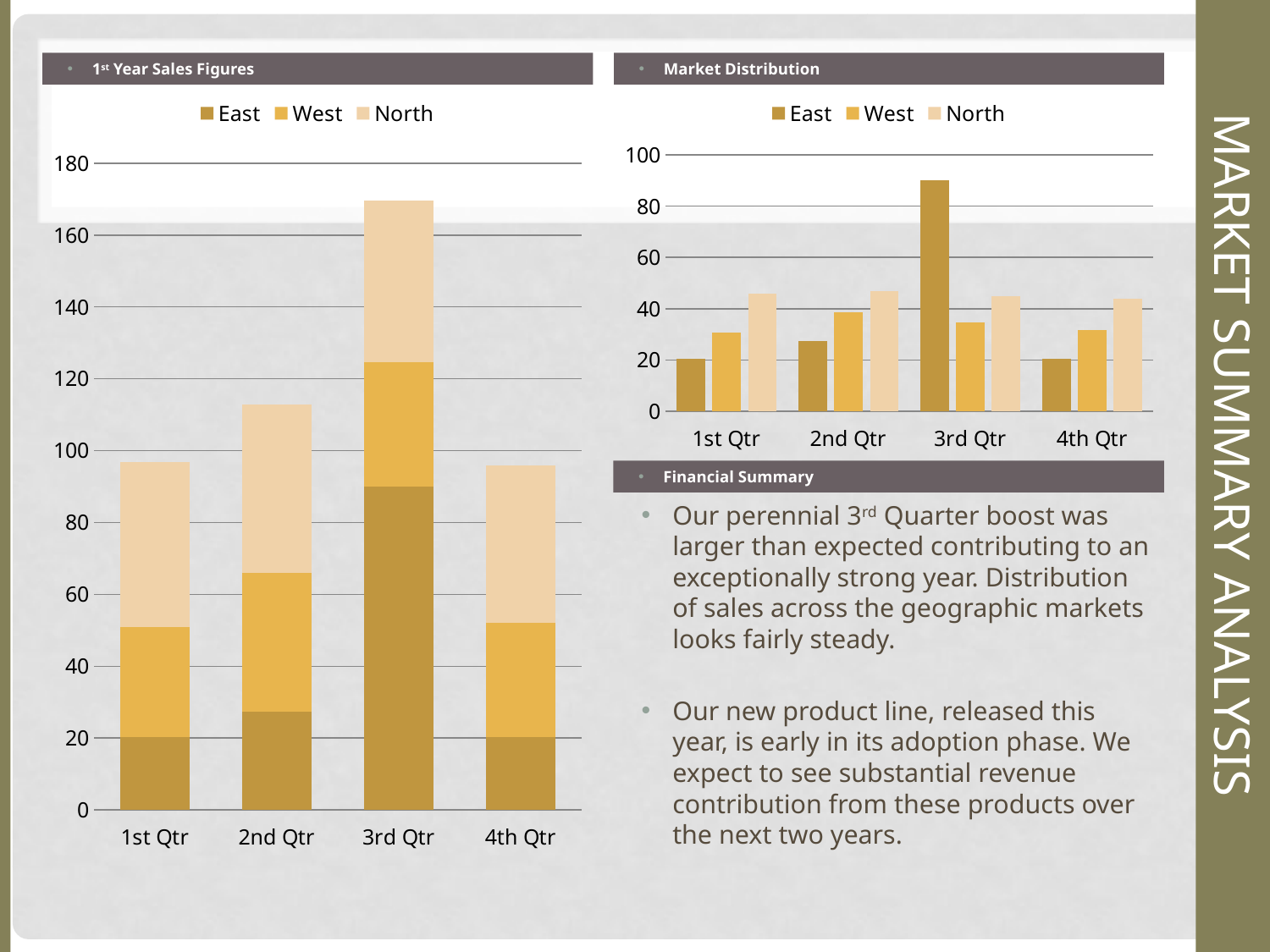
In the 'Market Distribution' chart, is the East value for 3rd Qtr greater or less than 80? greater In the '1st Year Sales Figures' chart, is the total stacked value for 3rd Qtr greater or less than 160? greater In the '1st Year Sales Figures' chart, is the total stacked value for 2nd Qtr greater or less than 120? less In the 'Market Distribution' chart, which quarter has the highest East value? 3rd Qtr What kind of chart is the 'Market Distribution' chart on the right? Bar chart How many quarters are shown on the x axis of the '1st Year Sales Figures' chart? 4 What kind of chart is the '1st Year Sales Figures' chart on the left? Stacked bar chart How many series does the legend of the '1st Year Sales Figures' chart list? 3 In the 'Market Distribution' chart, which is larger in 1st Qtr, East or North? North In the '1st Year Sales Figures' chart, which series is at the bottom of each stacked bar? East In the '1st Year Sales Figures' chart, which quarter has the tallest stacked bar? 3rd Qtr